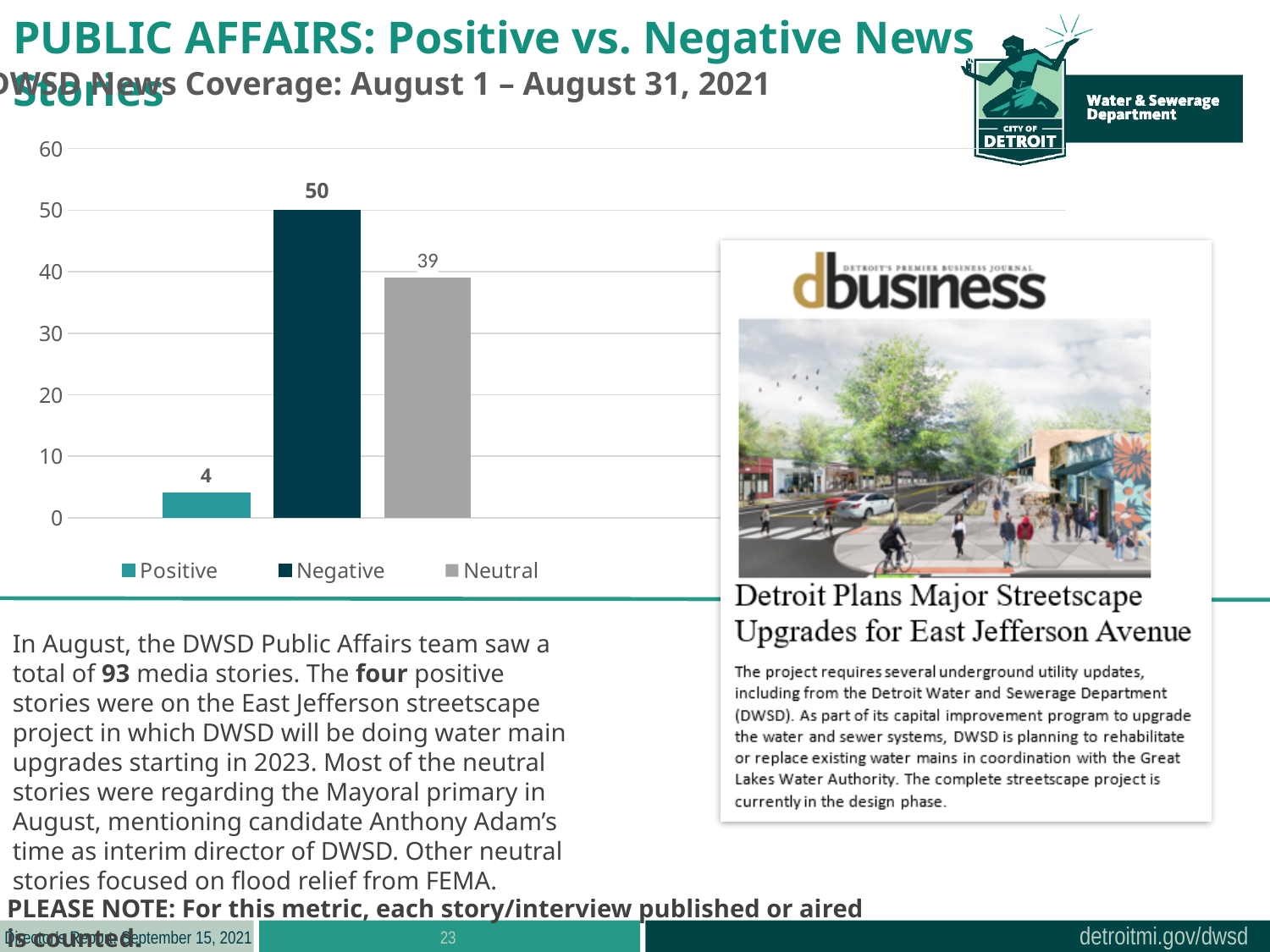
What is the difference between the Neutral and Positive story counts? 35 Which category has the highest number of stories? Negative What is the value for Negative news stories? 50 Which is larger, the Negative or the Neutral count? Negative How many series does the legend list? 3 What is the value for Neutral news stories? 39 What is the value for Positive news stories? 4 What is the total of the three story counts shown in the chart? 93 Is the value for Neutral greater or less than 40? less Which category has the lowest number of stories? Positive What kind of chart is shown on the slide? bar chart What is the difference between the Negative and Neutral story counts? 11